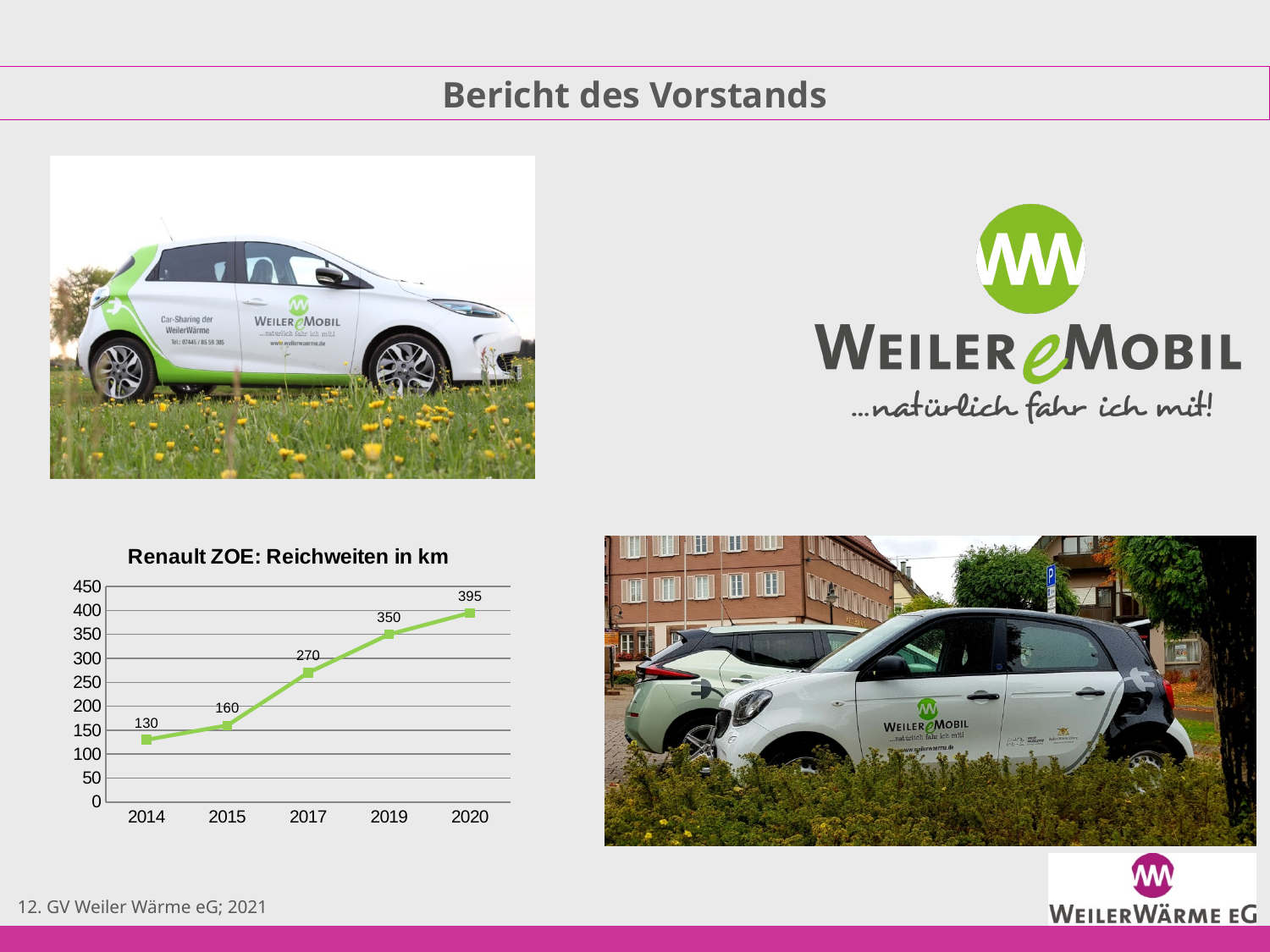
Is the value for 2019 greater or less than 300? greater How many years are plotted on the chart? 5 Which is larger, the range for 2015 or the range for 2017? 2017 What is the difference in range between 2019 and 2017? 80 Do the values rise or fall from 2014 to 2020? rise What is the range in km for 2017? 270 What kind of chart is shown? line chart What is the range in km for 2014? 130 What is the range in km for 2020? 395 What is the difference in range between 2020 and 2014? 265 Which year has the lowest range? 2014 Which year has the highest range? 2020